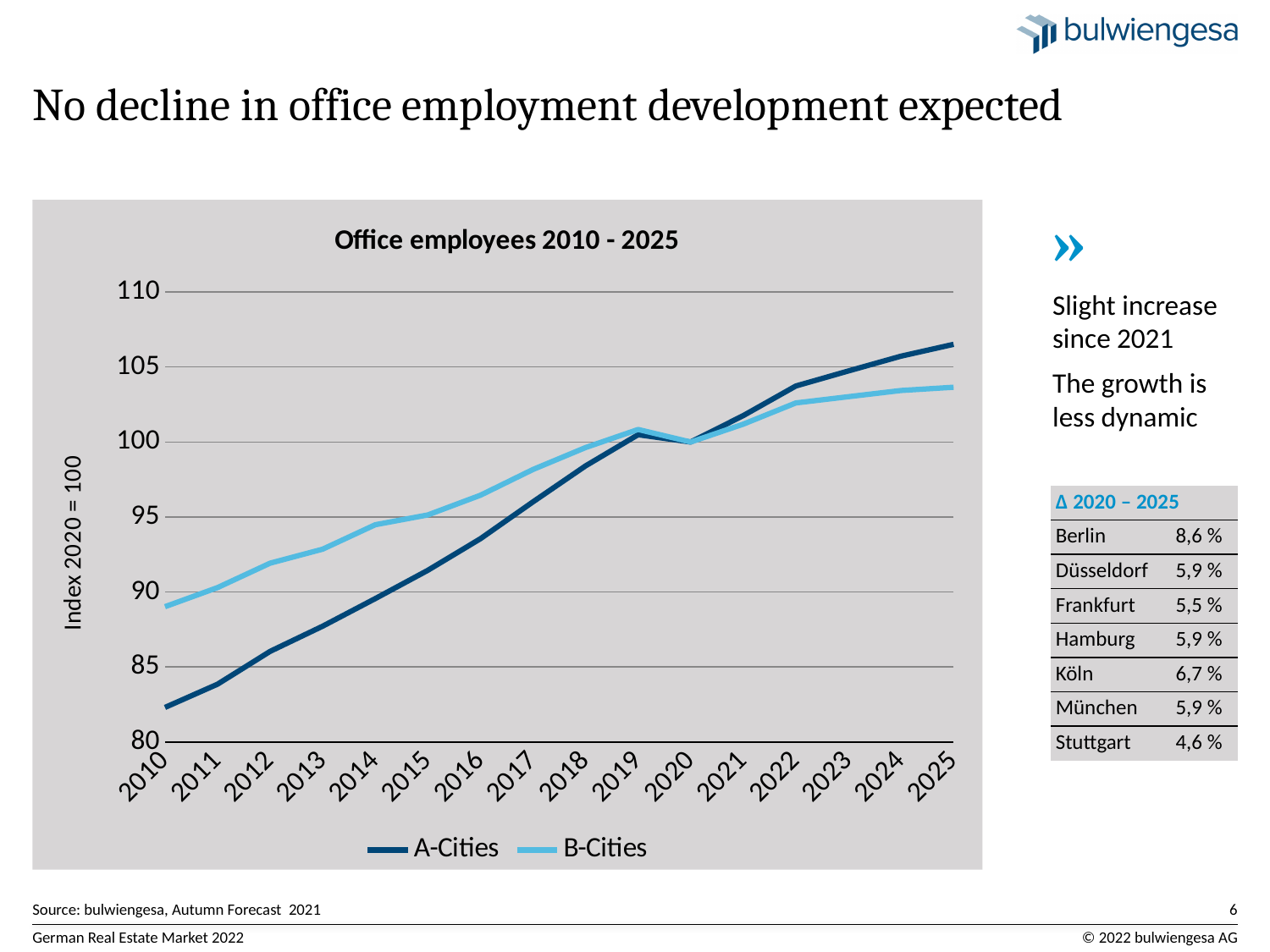
What is the index value for B-Cities in 2020? 100 In 2010, which series has the higher index value, A-Cities or B-Cities? B-Cities Do the A-Cities values generally rise or fall from 2010 to 2025? rise What is the index value for A-Cities in 2020? 100 What is the label on the chart's vertical axis? Index 2020 = 100 What is the title of the chart? Office employees 2010 - 2025 Is the value for B-Cities in 2025 greater or less than 105? less Is the value for A-Cities in 2010 greater or less than 85? less What kind of chart is shown on the slide? line chart How many series does the chart's legend list? 2 How many years are plotted along the x axis of the chart? 16 Is the value for A-Cities in 2025 greater or less than 105? greater